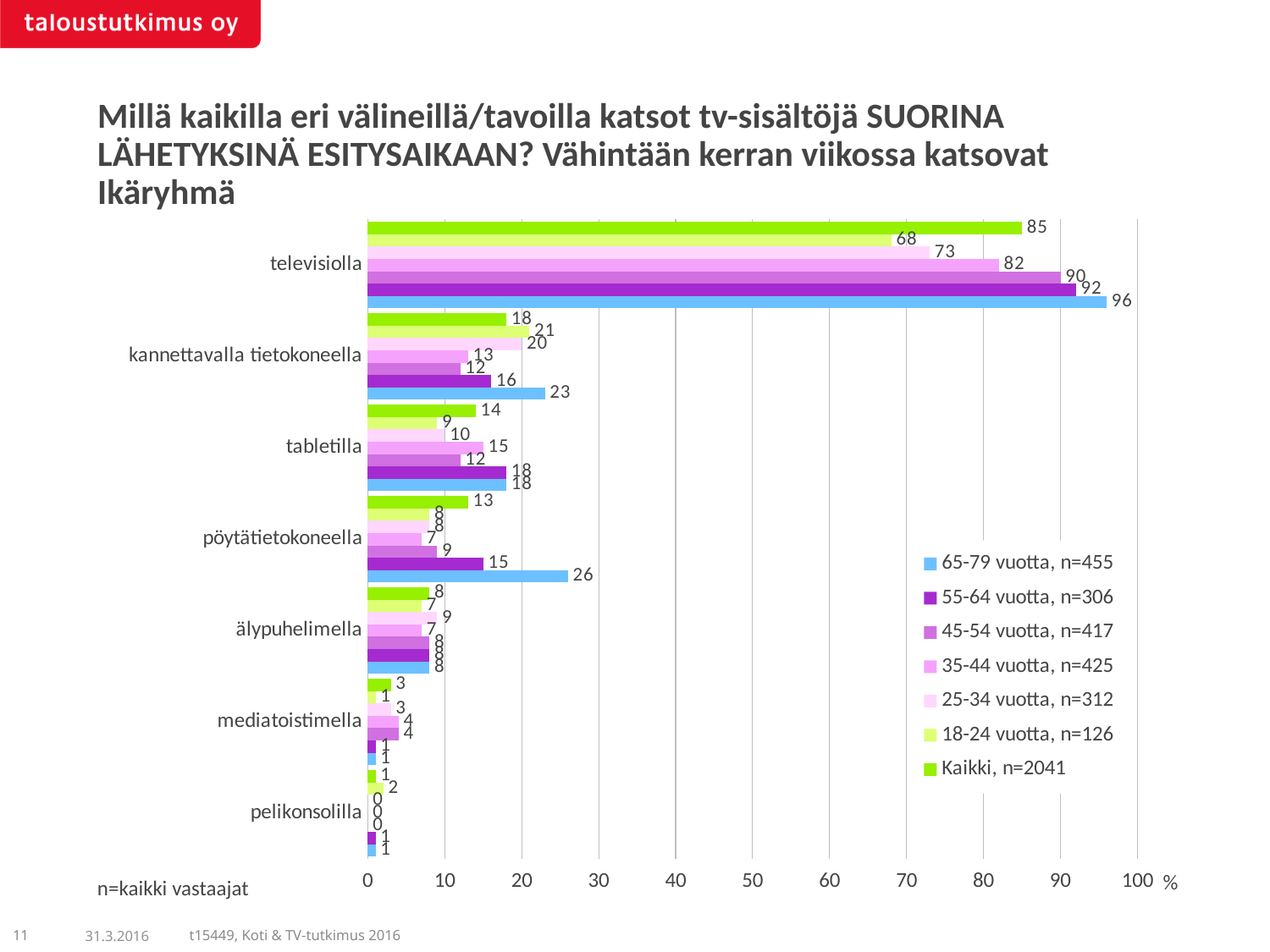
What is the value for televisiolla in the Kaikki, n=2041 series? 85 Is the value for televisiolla in the 45-54 vuotta series greater or less than 80? greater What is the value for pöytätietokoneella in the 65-79 vuotta, n=455 series? 26 How many categories (viewing methods) are shown on the chart? 7 What is the value for kannettavalla tietokoneella in the 18-24 vuotta, n=126 series? 21 Which age group has the lowest value for televisiolla? 18-24 vuotta, n=126 How many series does the legend list? 7 For pöytätietokoneella, which is larger: the 65-79 vuotta value or the 55-64 vuotta value? 65-79 vuotta Which age group has the highest value for televisiolla? 65-79 vuotta, n=455 What is the value for televisiolla in the 65-79 vuotta, n=455 series? 96 What is the difference between the 65-79 vuotta and 18-24 vuotta values for televisiolla? 28 What kind of chart is shown on the slide? bar chart